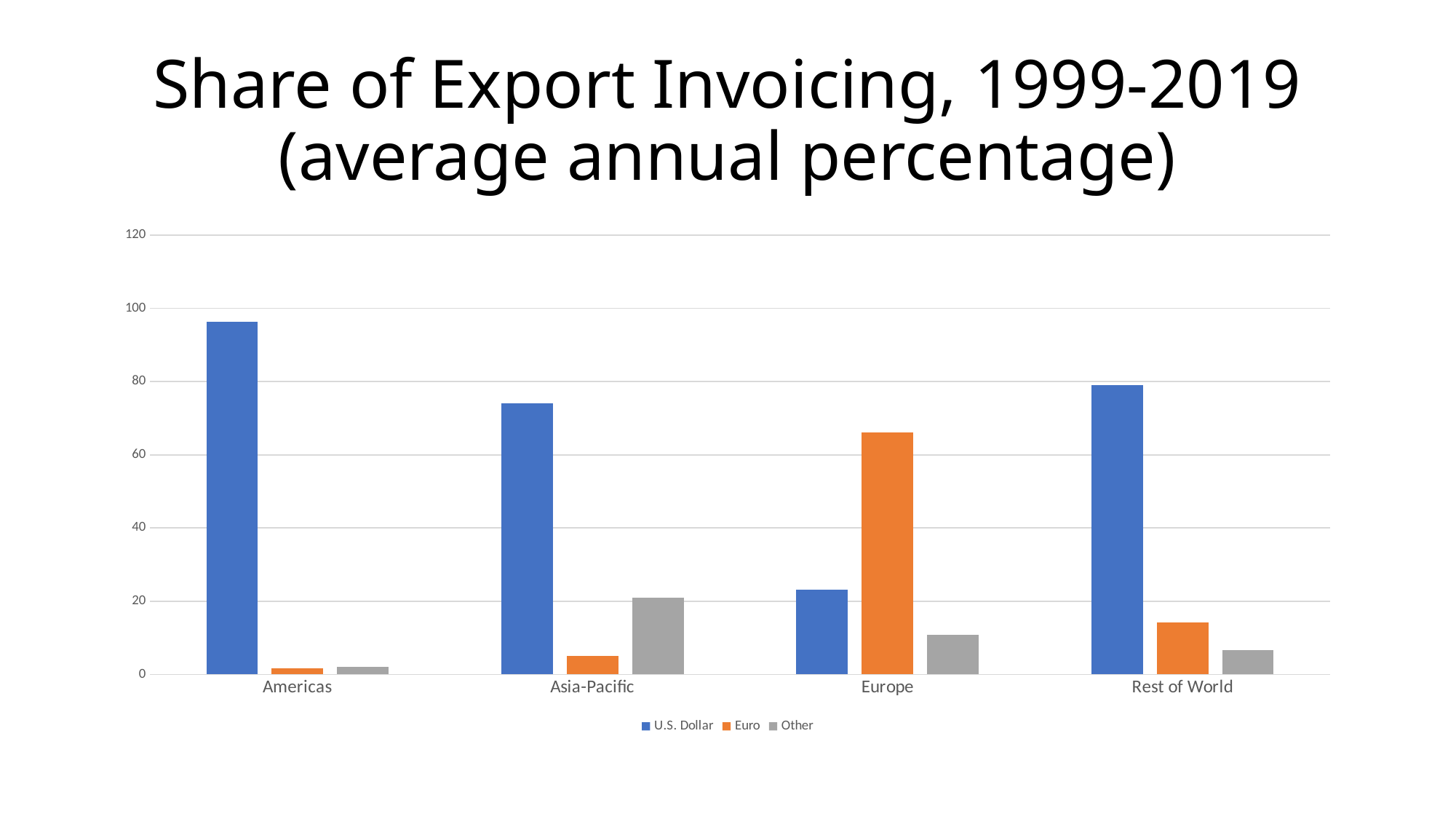
Which region has the highest Euro share of export invoicing? Europe Is the U.S. Dollar value for Americas greater or less than 80? greater Which region has the lowest U.S. Dollar share of export invoicing? Europe In Europe, which is larger: the U.S. Dollar share or the Euro share? Euro Which region has the highest U.S. Dollar share of export invoicing? Americas Which region has the highest Other share of export invoicing? Asia-Pacific Is the Euro value for Europe greater or less than 60? greater How many regions are shown on the x axis of the chart? 4 How many series does the legend list? 3 What is the title of the chart on the slide? Share of Export Invoicing, 1999-2019 (average annual percentage) Is the Euro value for Rest of World greater or less than 20? less What kind of chart is shown on the slide? bar chart